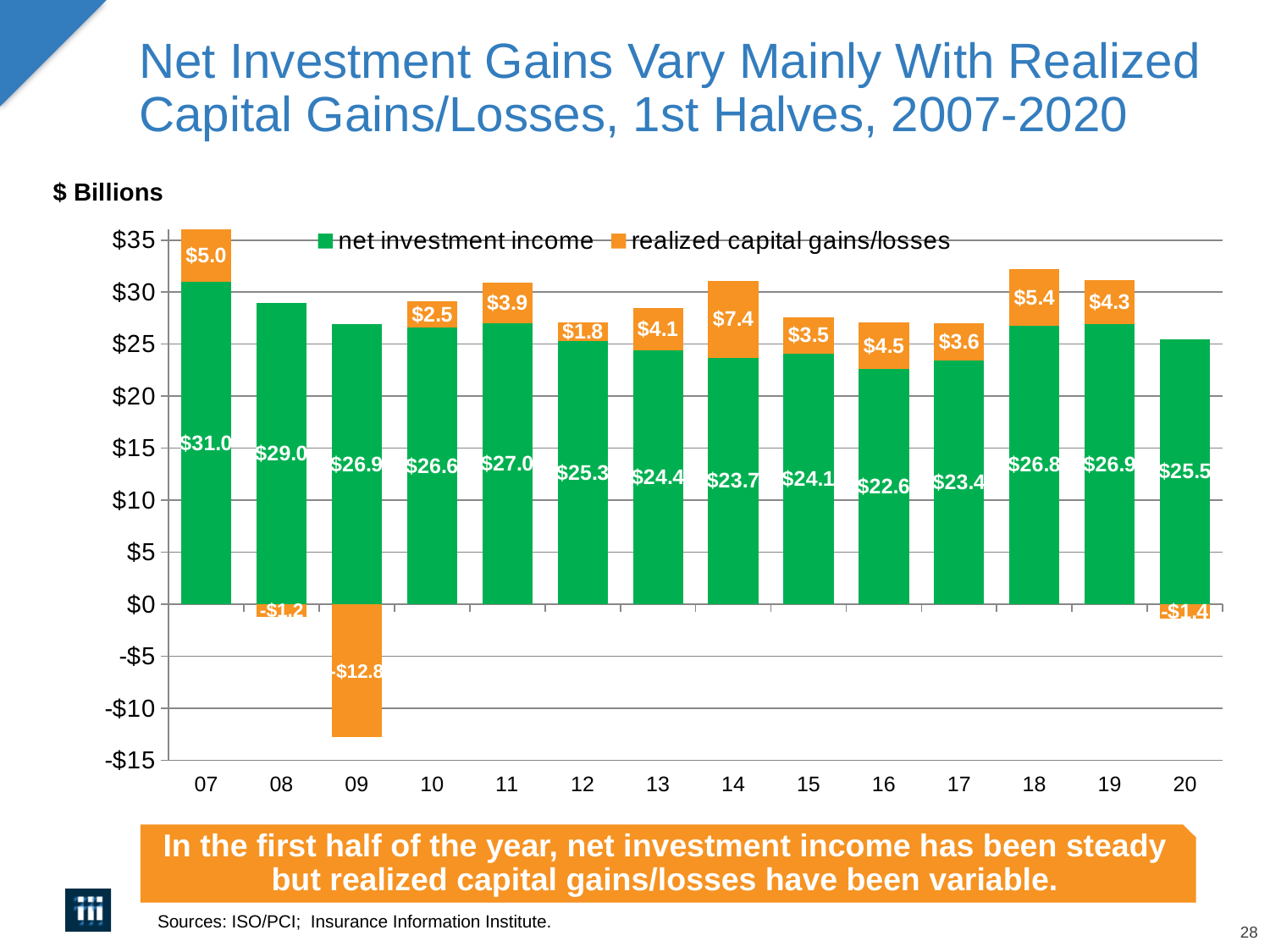
How many series does the legend list? 2 What is the difference between net investment income in 2007 and 2008? $2.0 Which year had the highest net investment income? 07 What was net investment income in the first half of 2007? $31.0 Which year had the lowest realized capital gains/losses? 09 Which year had the lowest net investment income? 16 What is the total of the stacked bar for 2014 (net investment income plus realized capital gains)? $31.1 What were realized capital gains/losses in the first half of 2014? $7.4 How many years are shown on the x axis? 14 Were realized capital gains larger in 2018 or 2019? 2018 Which year had the largest realized capital gains? 14 What were realized capital gains/losses in the first half of 2009? -$12.8